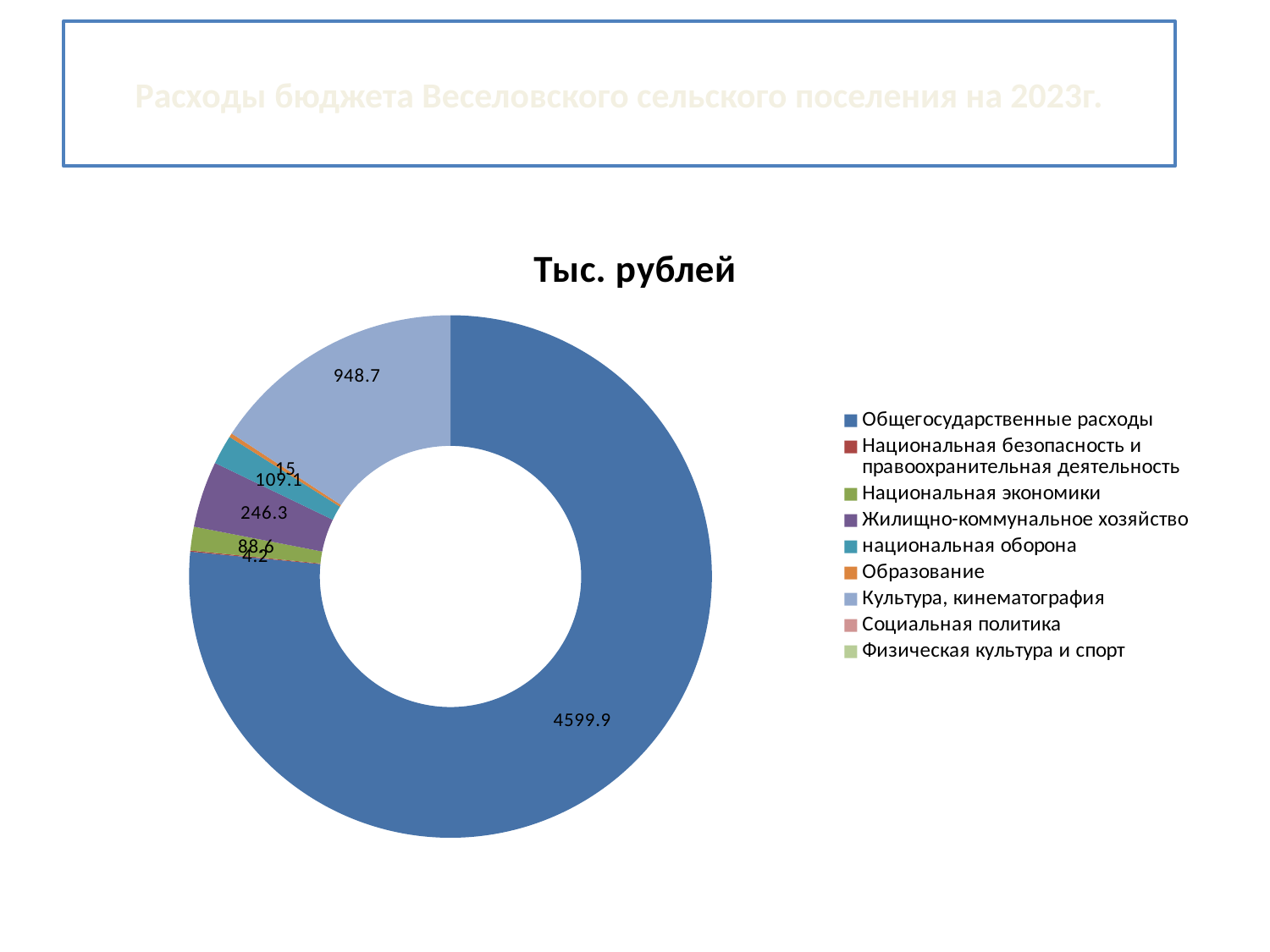
What is the difference between Общегосударственные расходы and Культура, кинематография? 3651.2 Which is larger: Культура, кинематография or Жилищно-коммунальное хозяйство? Культура, кинематография What is the value for Жилищно-коммунальное хозяйство? 246.3 What colour is the slice for Общегосударственные расходы? blue What is the value for Культура, кинематография? 948.7 What is the value for национальная оборона? 109.1 What is the title of the chart? Тыс. рублей What kind of chart is shown on the slide? doughnut chart How many categories does the legend list? 9 What is the difference between Культура, кинематография and Жилищно-коммунальное хозяйство? 702.4 Which category has the largest slice? Общегосударственные расходы What is the value for Общегосударственные расходы? 4599.9